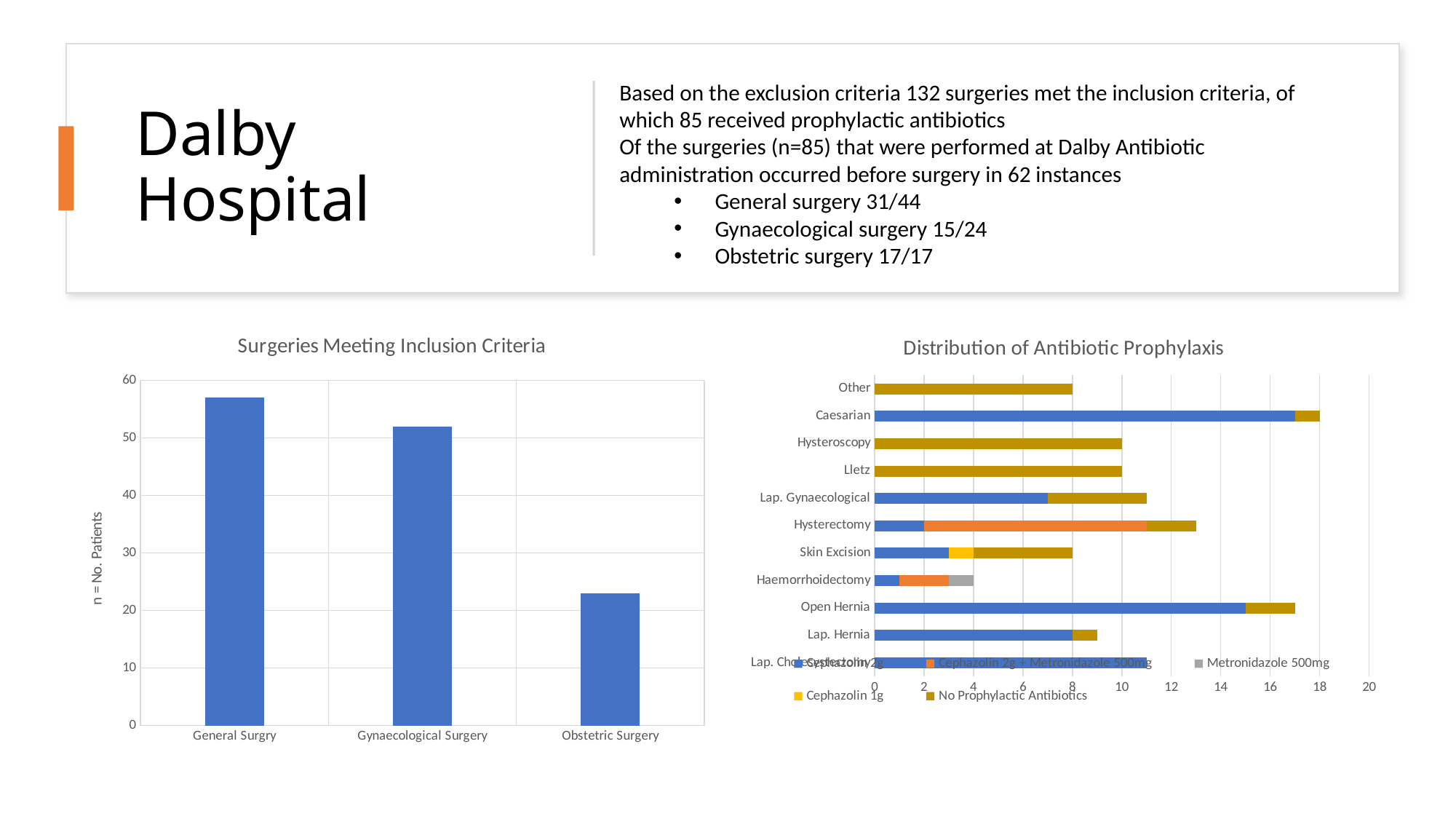
In the 'Surgeries Meeting Inclusion Criteria' chart, is the value for Obstetric Surgery greater or less than 30? less How many categories are shown in the 'Surgeries Meeting Inclusion Criteria' chart? 3 In the 'Distribution of Antibiotic Prophylaxis' chart, which has the longer total bar: Hysterectomy or Lap. Gynaecological? Hysterectomy What kind of chart is 'Surgeries Meeting Inclusion Criteria'? Bar chart In the 'Distribution of Antibiotic Prophylaxis' chart, which series is shown in orange? Cephazolin 2g + Metronidazole 500mg In the 'Surgeries Meeting Inclusion Criteria' chart, which is larger: General Surgry or Gynaecological Surgery? General Surgry In the 'Surgeries Meeting Inclusion Criteria' chart, which category has the lowest value? Obstetric Surgery What kind of chart is 'Distribution of Antibiotic Prophylaxis'? Stacked bar chart How many series does the legend of the 'Distribution of Antibiotic Prophylaxis' chart list? 5 In the 'Distribution of Antibiotic Prophylaxis' chart, is the total bar length for Haemorrhoidectomy greater or less than 6? less In the 'Surgeries Meeting Inclusion Criteria' chart, is the value for General Surgry greater or less than 50? greater In the 'Surgeries Meeting Inclusion Criteria' chart, which category has the highest value? General Surgry